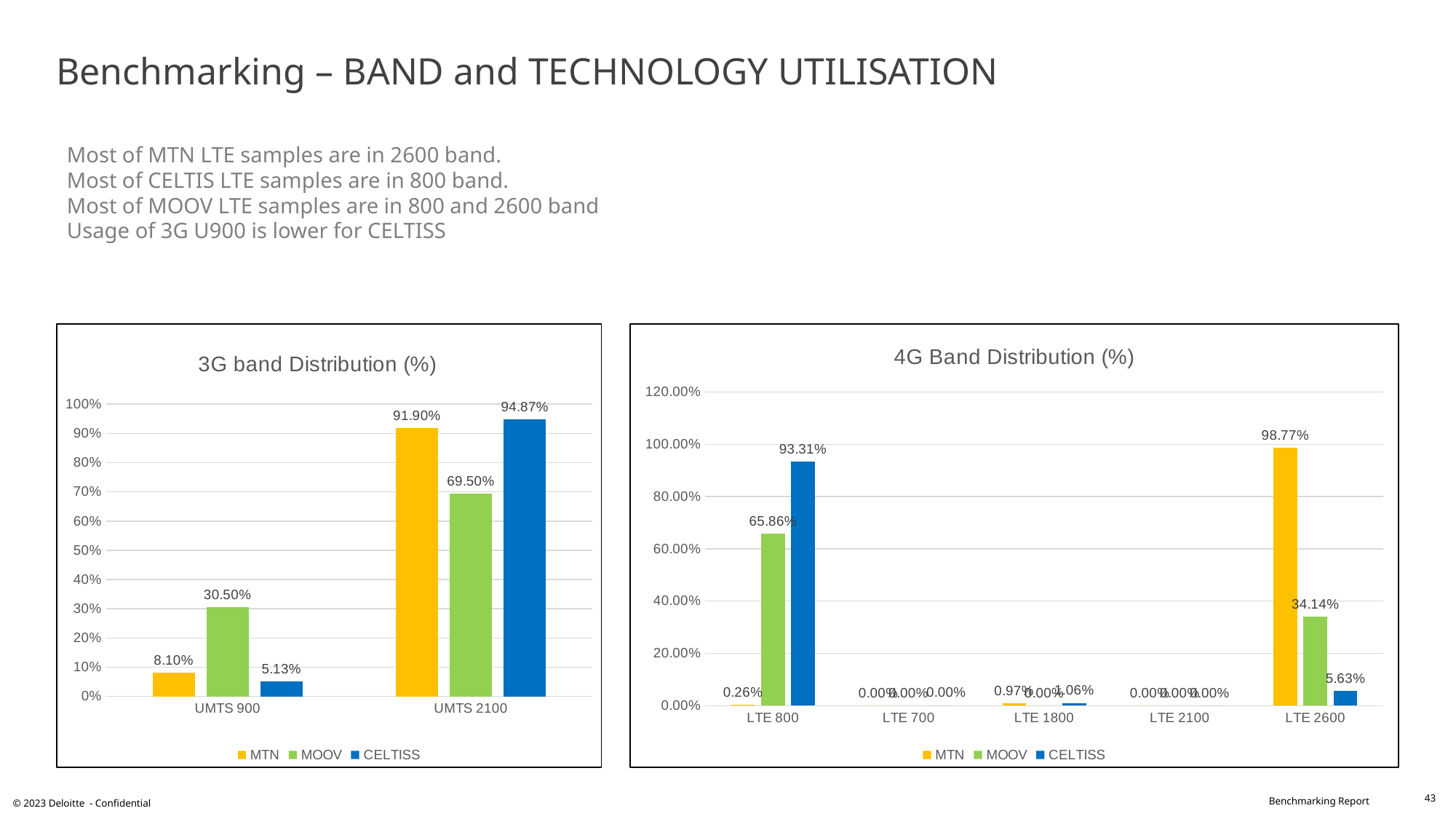
In the 3G band Distribution (%) chart, how many series does the legend list? 3 What kind of chart is the 4G Band Distribution (%) chart? Bar chart In the 3G band Distribution (%) chart, which operator has the lowest value at UMTS 900? CELTISS In the 4G Band Distribution (%) chart, what is the value for CELTISS at LTE 800? 93.31% In the 4G Band Distribution (%) chart, what is the difference between the CELTISS and MOOV values at LTE 800? 27.45% In the 3G band Distribution (%) chart, what is the value for CELTISS at UMTS 2100? 94.87% In the 4G Band Distribution (%) chart, is the MOOV value at LTE 800 larger or smaller than the MOOV value at LTE 2600? larger In the 4G Band Distribution (%) chart, what is the value for MTN at LTE 2600? 98.77% In the 4G Band Distribution (%) chart, how many band categories are shown on the x axis? 5 In the 3G band Distribution (%) chart, what is the value for MOOV at UMTS 900? 30.50% In the 4G Band Distribution (%) chart, which operator has the highest value at LTE 2600? MTN In the 3G band Distribution (%) chart, what is the difference between the MTN and MOOV values at UMTS 2100? 22.40%